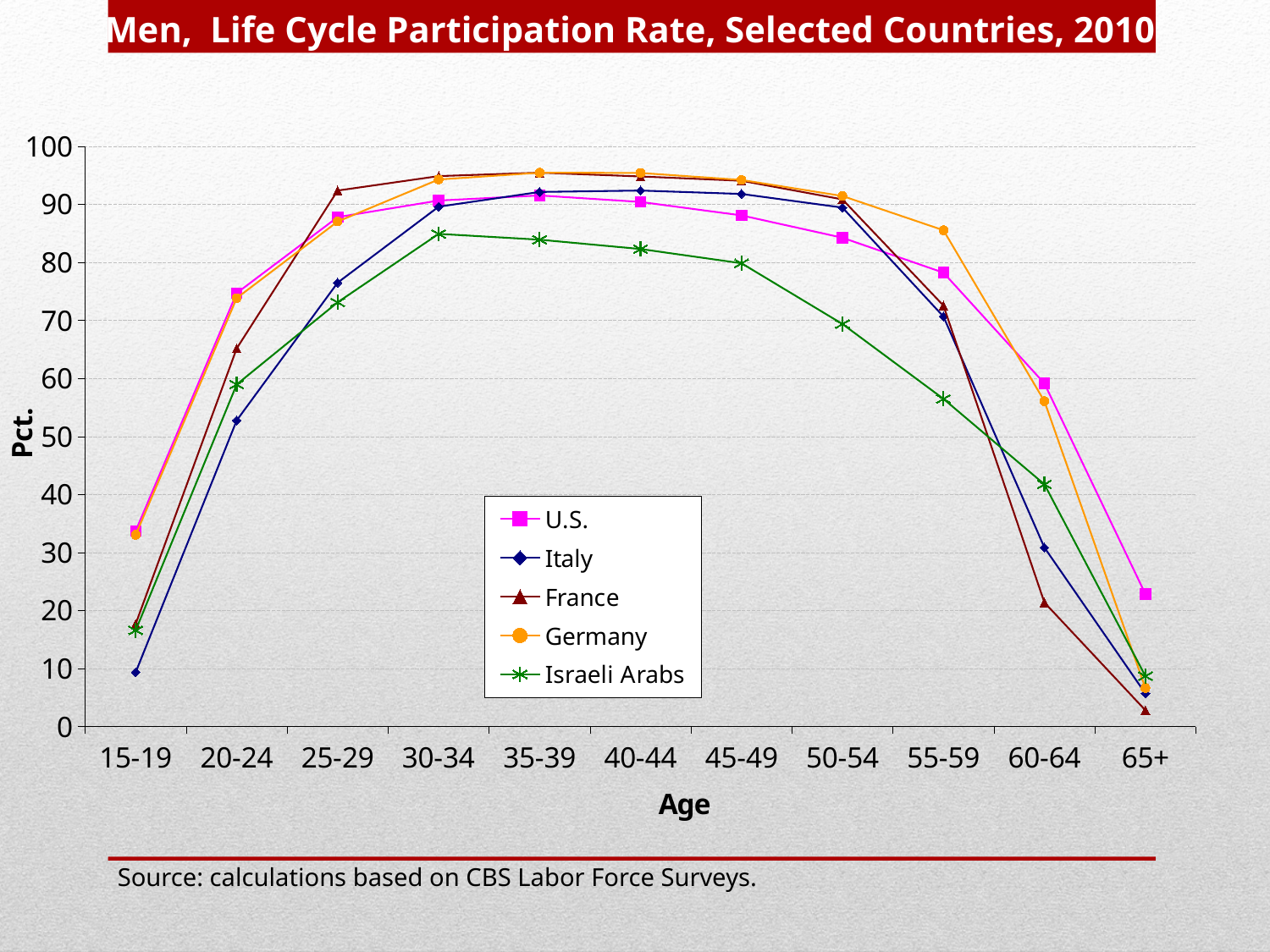
What kind of chart is shown on the slide? line chart At age 50-54, which is larger, the value for Italy or for Israeli Arabs? Italy Which series has the lowest value at age 15-19? Italy How many series does the legend list? 5 Is the value for Italy at age 15-19 greater or less than 20? less Is the value for Israeli Arabs at age 50-54 greater or less than 80? less Is the value for Germany at age 25-29 greater or less than 80? greater Which series has the highest value at age 55-59? Germany How many age groups are shown on the x axis? 11 At age 20-24, which is larger, the value for the U.S. or for Italy? U.S. Do the values for the U.S. rise or fall from age 40-44 to 65+? fall